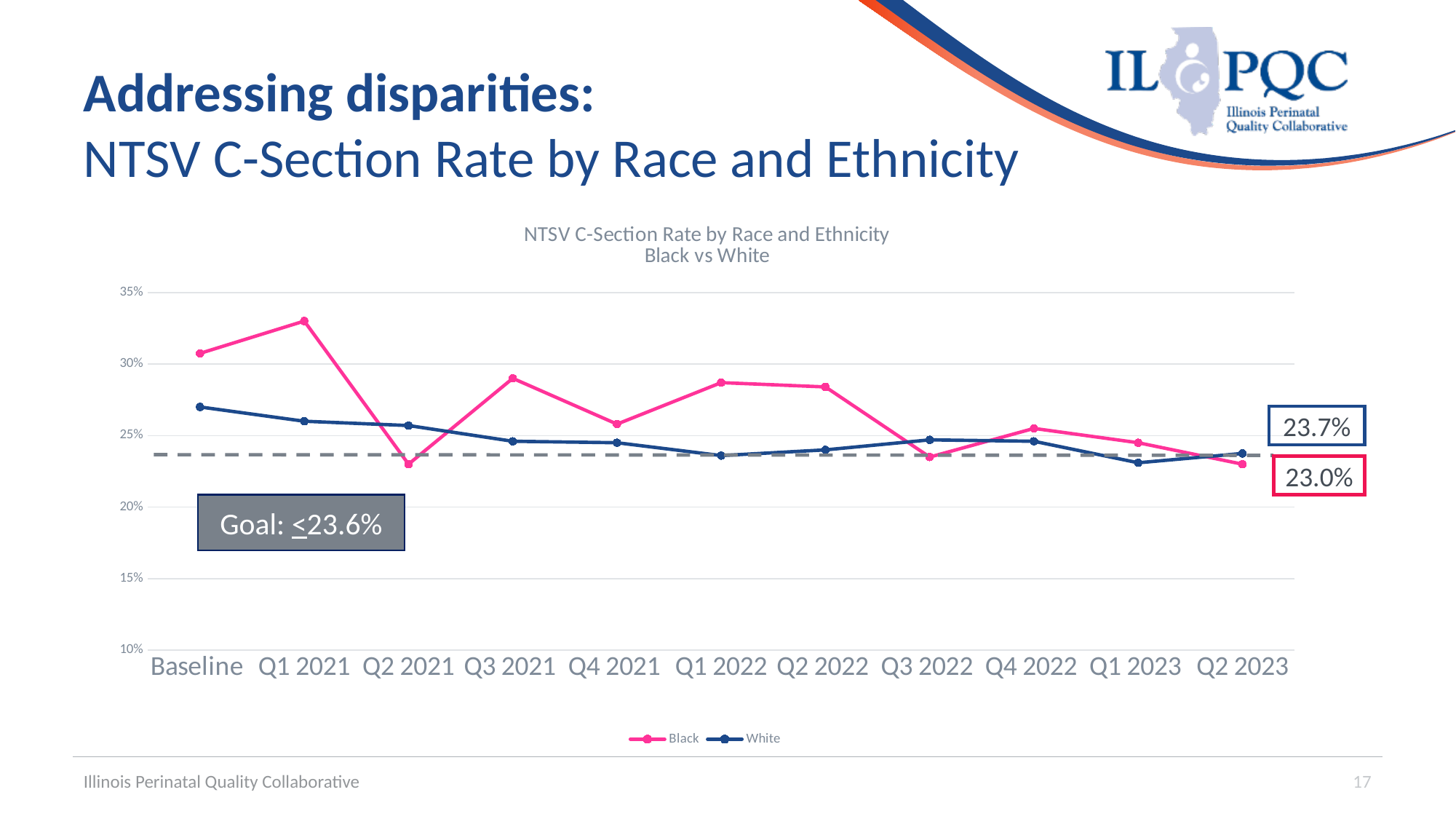
Is the rate for White patients at Baseline greater or less than 25%? greater Does the rate for White patients rise or fall overall from Baseline to Q2 2023? fall How many time points are shown on the x axis? 11 What type of chart is shown on the slide? line chart Is the rate for Black patients at Q1 2021 greater or less than 30%? greater What goal value is shown in the box on the chart? ≤23.6% At which time point is the rate for Black patients highest? Q1 2021 How many series does the legend list? 2 What is the NTSV C-section rate for White patients at Q2 2023? 23.7% What is the difference between the White and Black rates at Q2 2023? 0.7% What is the NTSV C-section rate for Black patients at Q2 2023? 23.0% At Q2 2023, which group has the higher rate, Black or White? White